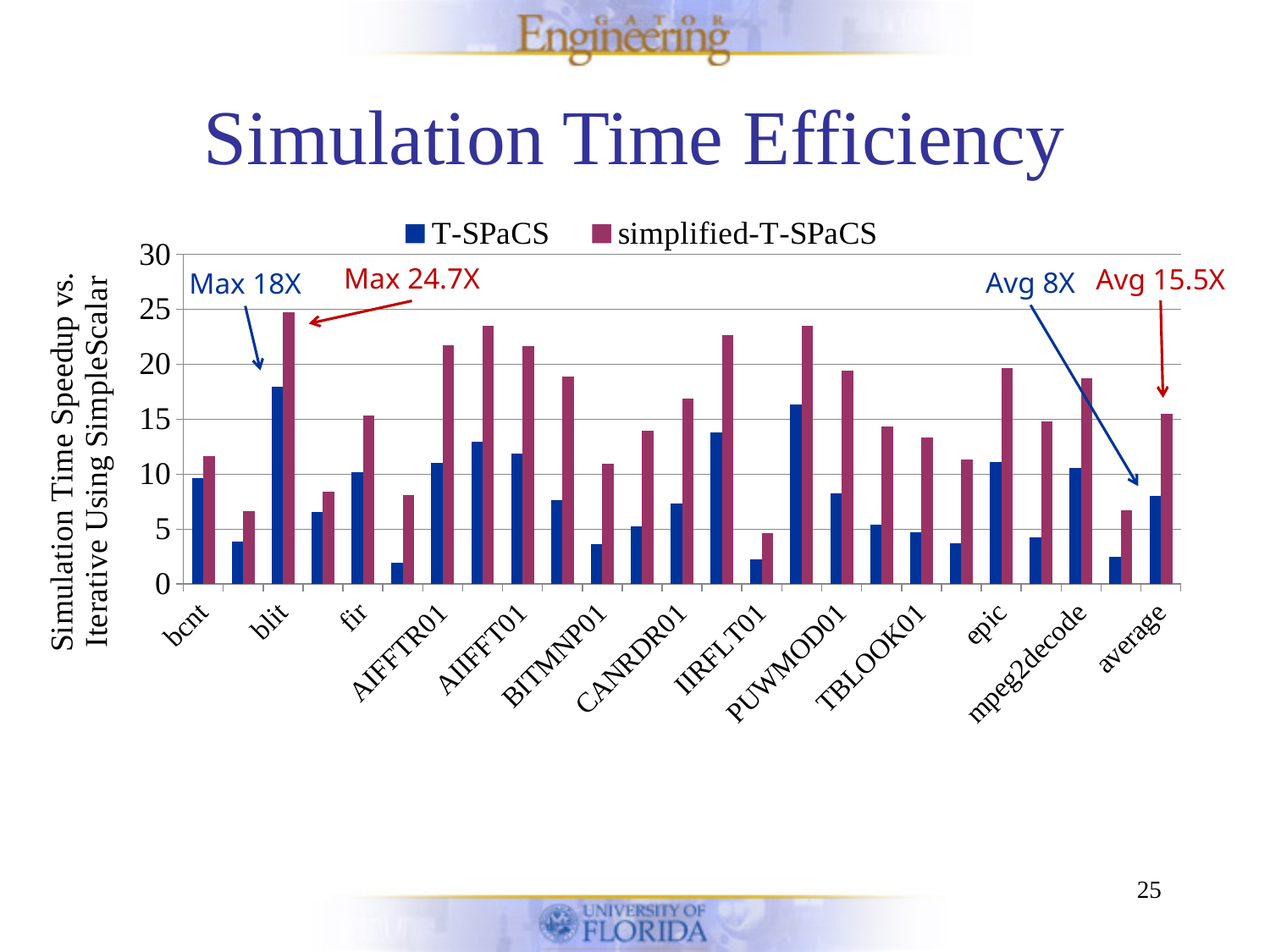
What is the maximum speedup annotated for simplified-T-SPaCS? 24.7X For the average category, which series has the larger value, T-SPaCS or simplified-T-SPaCS? simplified-T-SPaCS What kind of chart is shown on the slide? bar chart What is the average speedup annotated for simplified-T-SPaCS? 15.5X What is the average speedup annotated for T-SPaCS? 8X Is the simplified-T-SPaCS value for AIIFFT01 greater or less than 20? greater What are the two series named in the legend? T-SPaCS and simplified-T-SPaCS How many series does the legend list? 2 What is the difference between the annotated average speedups of simplified-T-SPaCS and T-SPaCS? 7.5X What is the maximum speedup annotated for T-SPaCS? 18X Which benchmark has the highest simplified-T-SPaCS speedup? blit What is the difference between the annotated maximum speedups of simplified-T-SPaCS and T-SPaCS? 6.7X